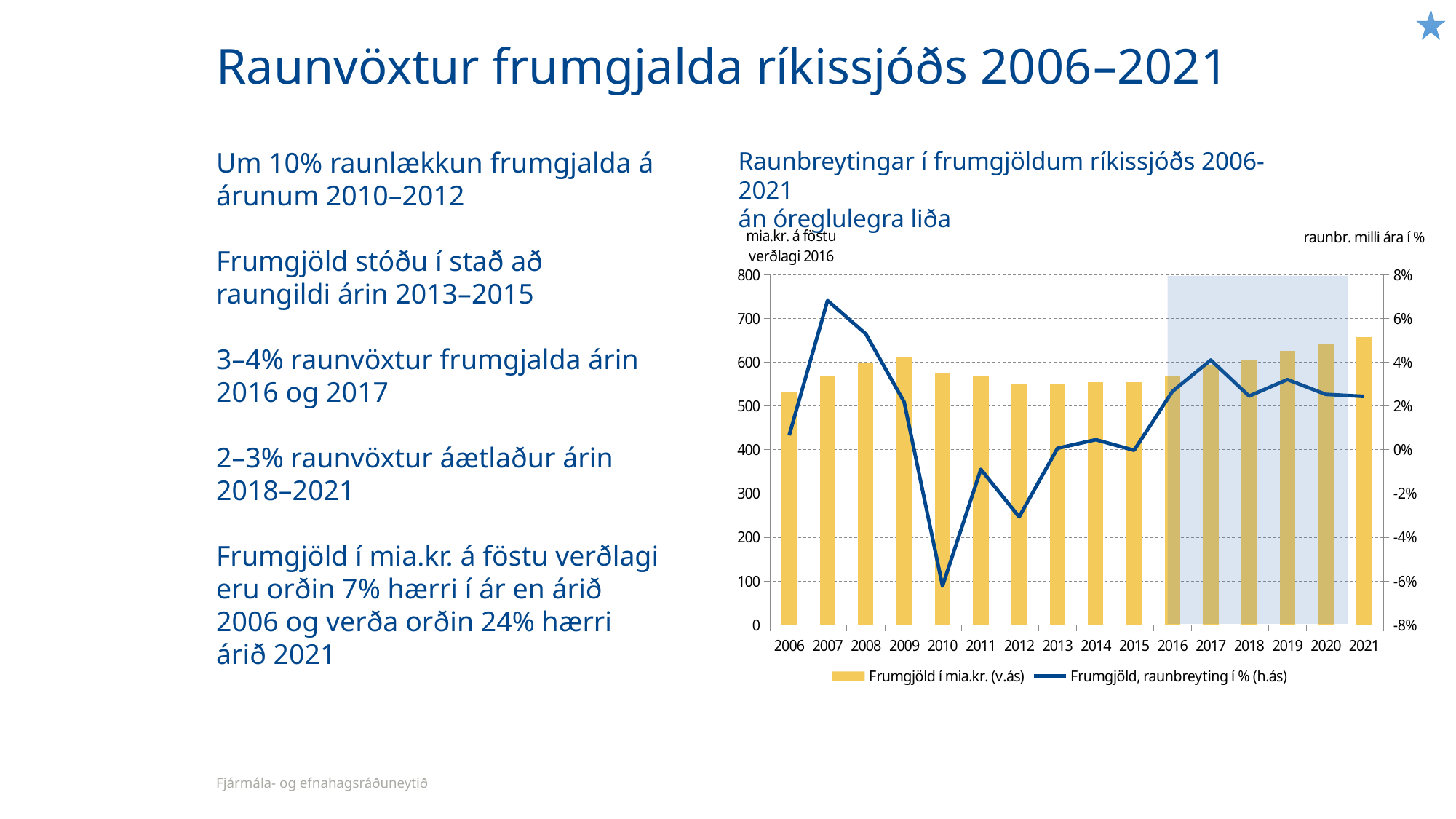
How many years are shown on the x axis of the chart? 16 Is the line value for 2010 greater or less than -4%? less In which year does the line Frumgjöld, raunbreyting í % reach its highest point? 2007 Which year has the tallest bar for Frumgjöld í mia.kr.? 2021 How many series does the chart legend list? 2 In which year does the line Frumgjöld, raunbreyting í % reach its lowest point? 2010 Which year has the taller bar, 2009 or 2010? 2009 Is the bar value for 2021 greater or less than 600? greater Is the line value for 2007 greater or less than 6%? greater Which year has the shortest bar for Frumgjöld í mia.kr.? 2006 Do the bars rise or fall from 2016 to 2021? rise What kind of chart is shown on the slide? Combined bar and line chart